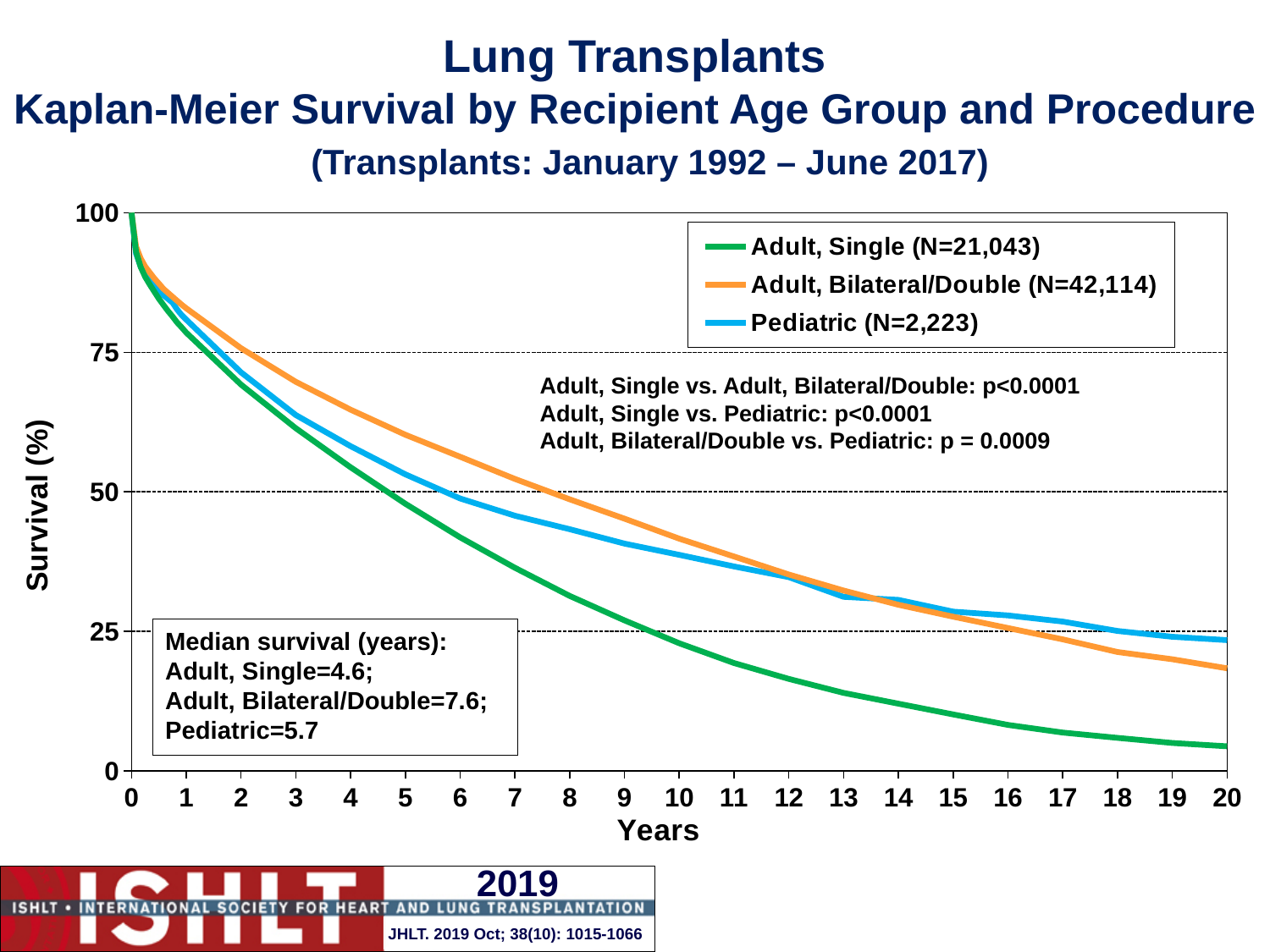
What is the median survival in years for Pediatric recipients? 5.7 What is the difference in median survival (years) between Adult, Bilateral/Double and Adult, Single? 3.0 Which group has the lowest median survival? Adult, Single Is the survival for Adult, Bilateral/Double at 5 years greater or less than 50? greater Do the survival curves rise or fall as years increase? fall How many series does the legend list? 3 At 20 years, which curve shows higher survival: Pediatric or Adult, Single? Pediatric What is the median survival in years for Adult, Single recipients? 4.6 What is the median survival in years for Adult, Bilateral/Double recipients? 7.6 Is the survival for Adult, Single at 20 years greater or less than 25? less Which group has the highest median survival? Adult, Bilateral/Double What kind of chart is shown on the slide? line chart